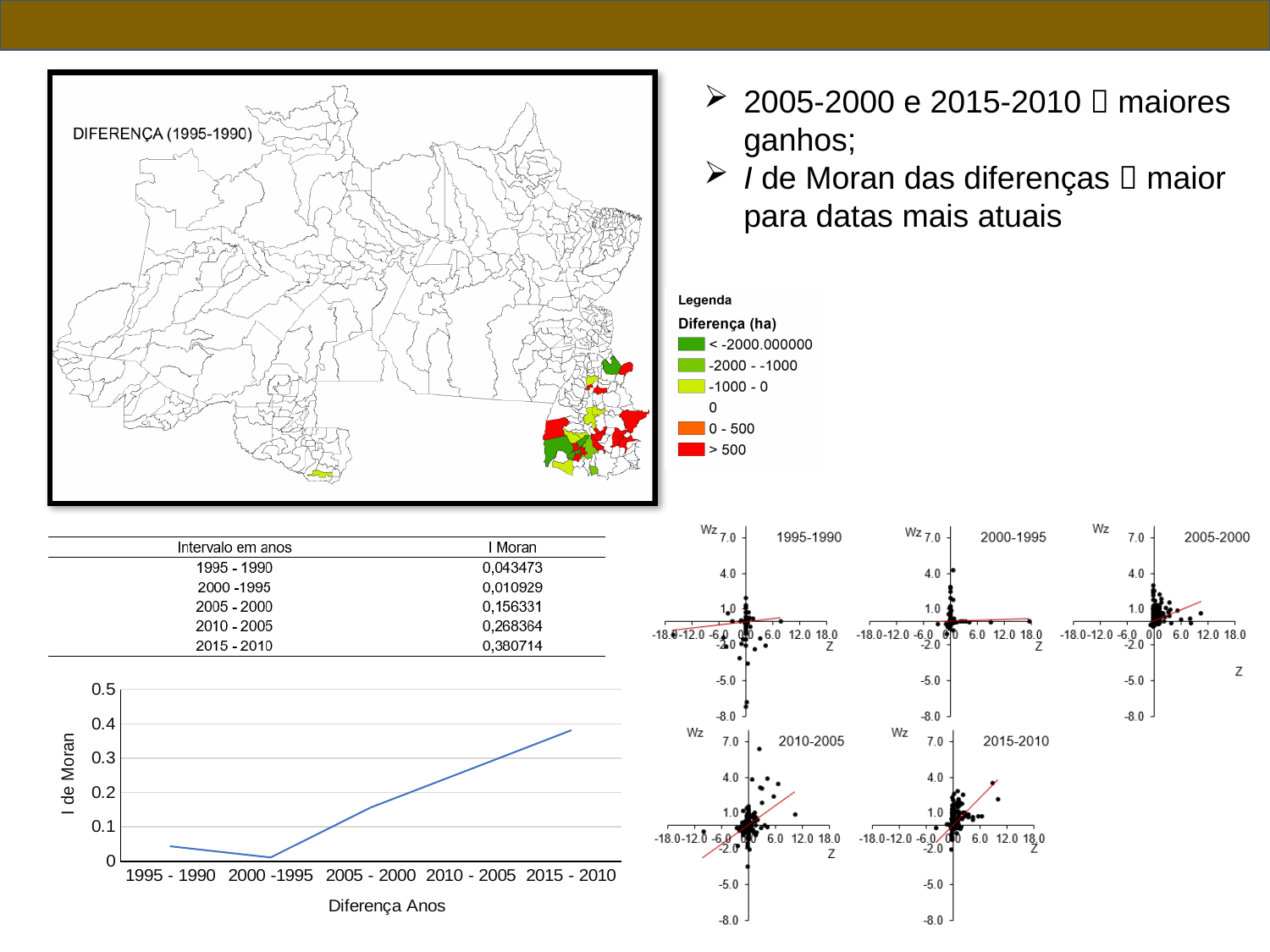
In the line chart at the bottom left, how many year-interval categories are shown on the x axis? 5 In the line chart at the bottom left, is the value for 2015 - 2010 greater or less than 0.3? greater In the line chart at the bottom left, which year interval has the lowest I de Moran value? 2000 -1995 In the line chart at the bottom left, is the value for 1995 - 1990 greater or less than 0.1? less How many scatter plots (Wz versus Z) are shown on the right side of the slide? 5 What kind of chart is the chart at the bottom left of the slide with the y axis labelled 'I de Moran'? line chart According to the table above the line chart, what is the I Moran value for the interval 2015 - 2010? 0,380714 In the line chart at the bottom left, which year interval has the highest I de Moran value? 2015 - 2010 In the line chart at the bottom left, is the value for 2005 - 2000 greater or less than 0.2? less In the line chart at the bottom left, which has the larger I de Moran value, 2010 - 2005 or 2005 - 2000? 2010 - 2005 What is the x-axis title of the line chart at the bottom left? Diferença Anos In the line chart at the bottom left, does the I de Moran value rise or fall from 2000 -1995 to 2015 - 2010? rise